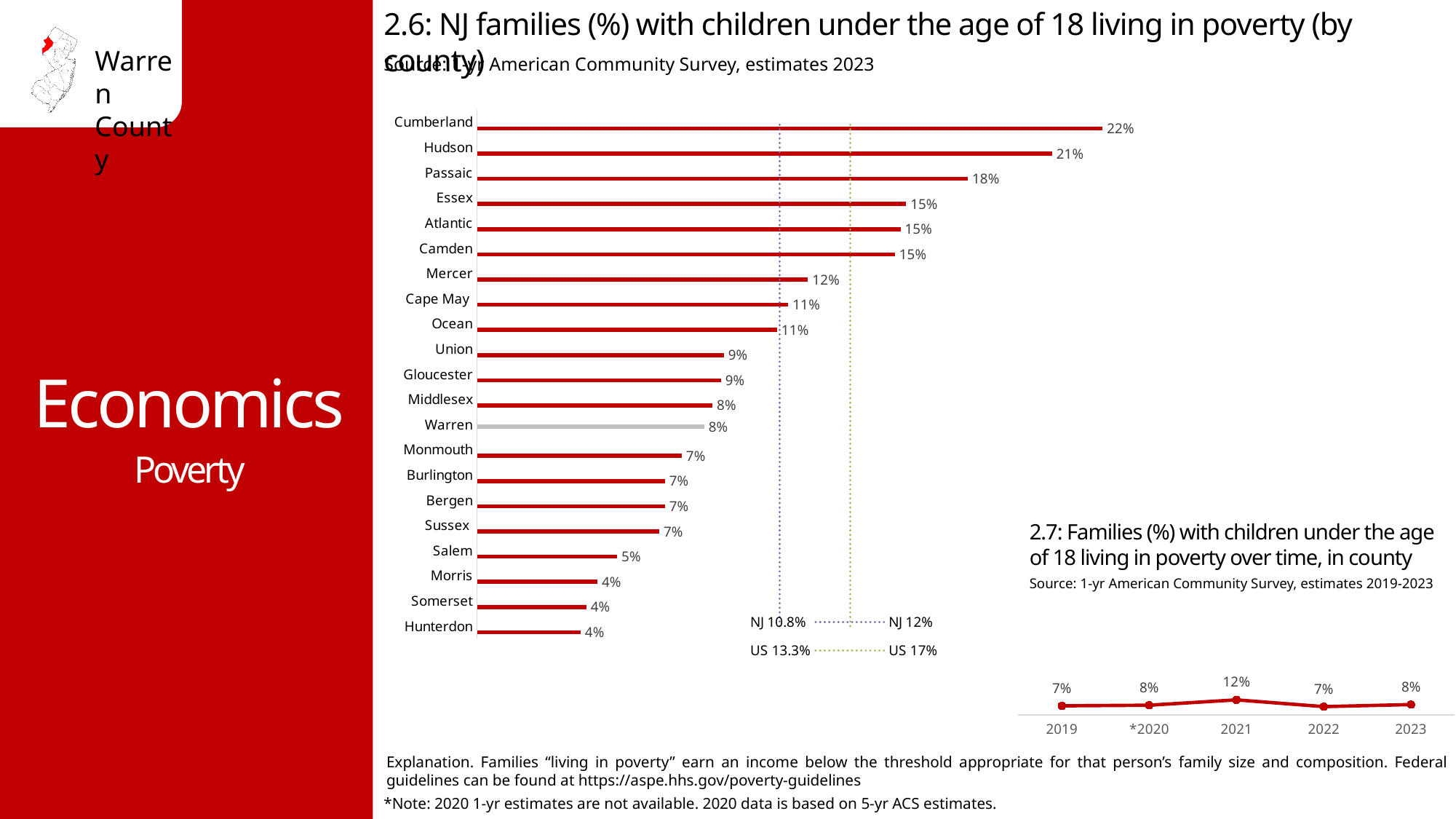
In chart 2.6 (by county), what is the difference between Hudson and Passaic? 3% In chart 2.6 (NJ families with children under 18 living in poverty by county), what is the value for Cumberland? 22% What kind of chart is chart 2.6 (by county)? Bar chart In chart 2.7 (over time, in county), how many years are plotted? 5 In chart 2.6 (by county), which is larger, the value for Mercer or the value for Salem? Mercer In chart 2.7 (families in poverty over time, in county), what is the value for 2021? 12% In chart 2.7 (over time, in county), what is the difference between 2021 and 2022? 5% In chart 2.6 (by county), how many counties are plotted? 21 In chart 2.6 (by county), which county has the highest value? Cumberland In chart 2.6 (by county), what is the value for Warren? 8% In chart 2.7 (over time, in county), which year has the highest value? 2021